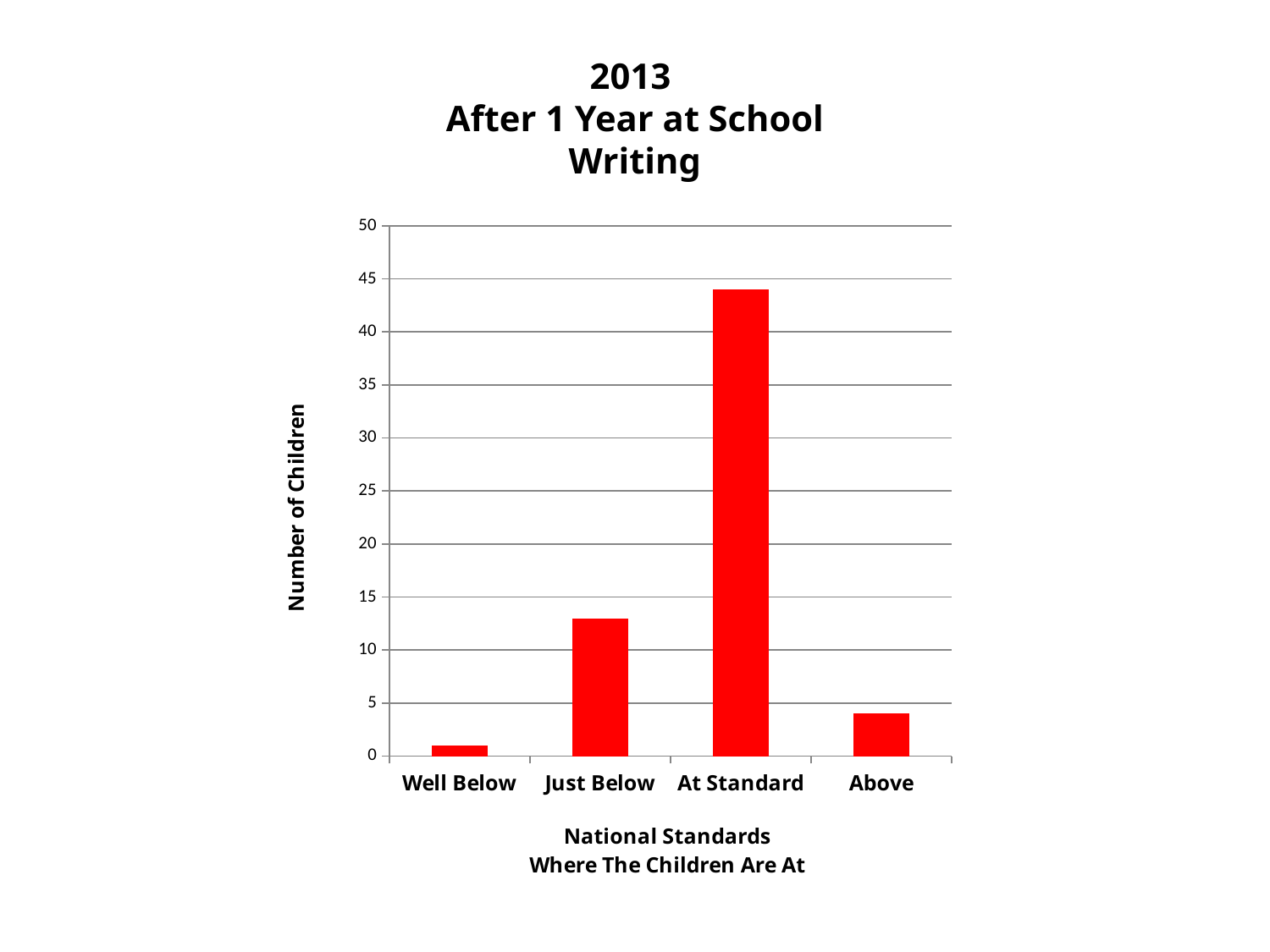
Which category has the highest number of children? At Standard Is the value for Just Below greater or less than 10? greater What kind of chart is shown on the slide? Bar chart Which is larger, the value for Well Below or the value for Above? Above Which category has the lowest number of children? Well Below What colour are the bars in the chart? Red Which is larger, the value for Just Below or the value for Above? Just Below Is the value for At Standard greater or less than 40? greater What is the label of the y axis? Number of Children Is the value for Well Below greater or less than 5? less How many categories are shown on the x axis? 4